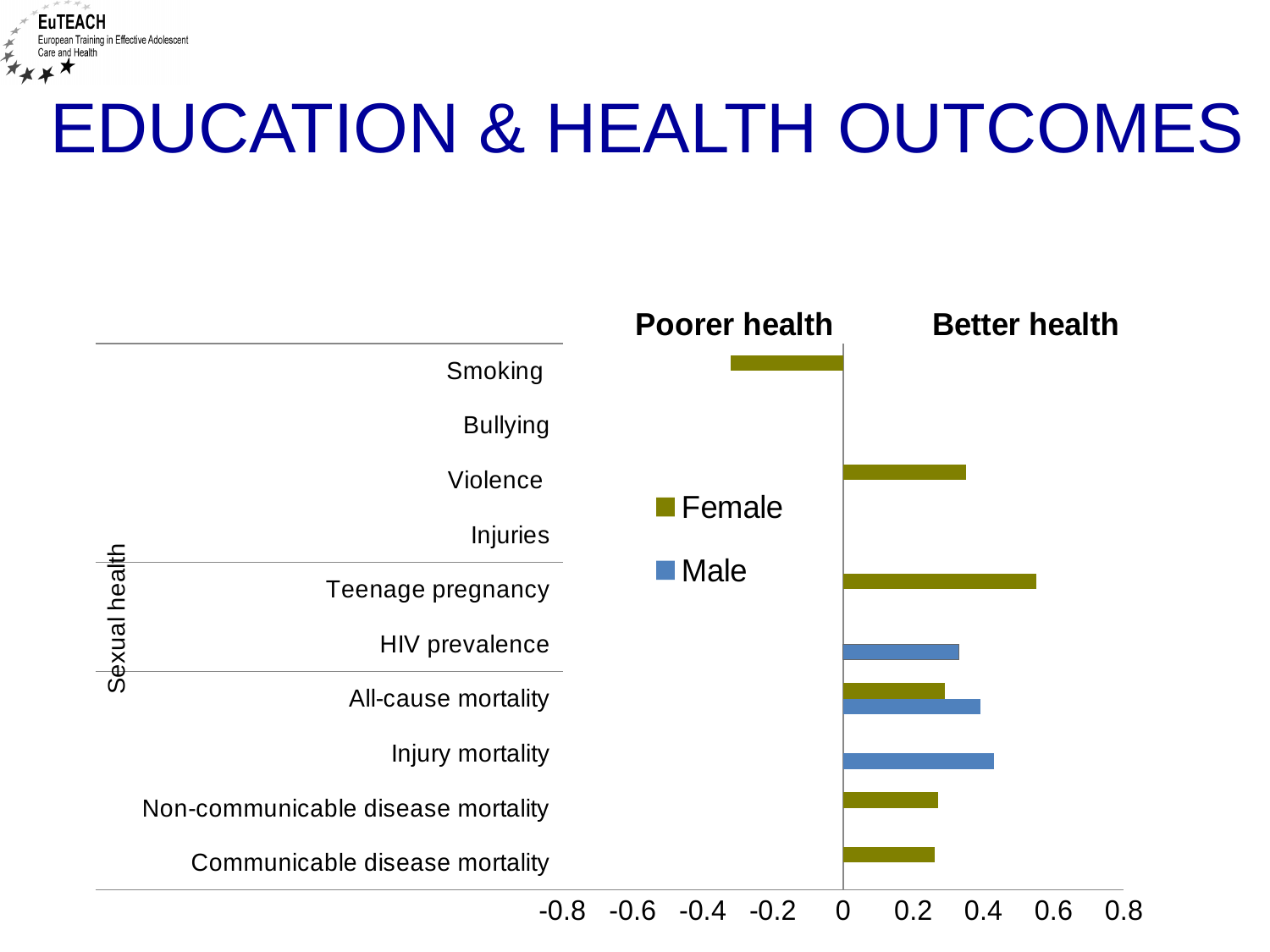
What kind of chart is shown on the slide? bar chart How many categories are listed on the vertical axis of the chart? 10 Which colour represents the Male series in the chart? blue Which category has the longest bar in the chart? Teenage pregnancy What label appears above the left (negative) side of the chart? Poorer health For All-cause mortality, which series has the larger value, Female or Male? Male How many series does the legend list? 2 Is the Female value for Violence greater or less than 0.2? greater Which category is the only one with a negative (Poorer health) bar? Smoking Is the Female value for Smoking greater or less than 0? less Is the Male value for HIV prevalence greater or less than 0.2? greater